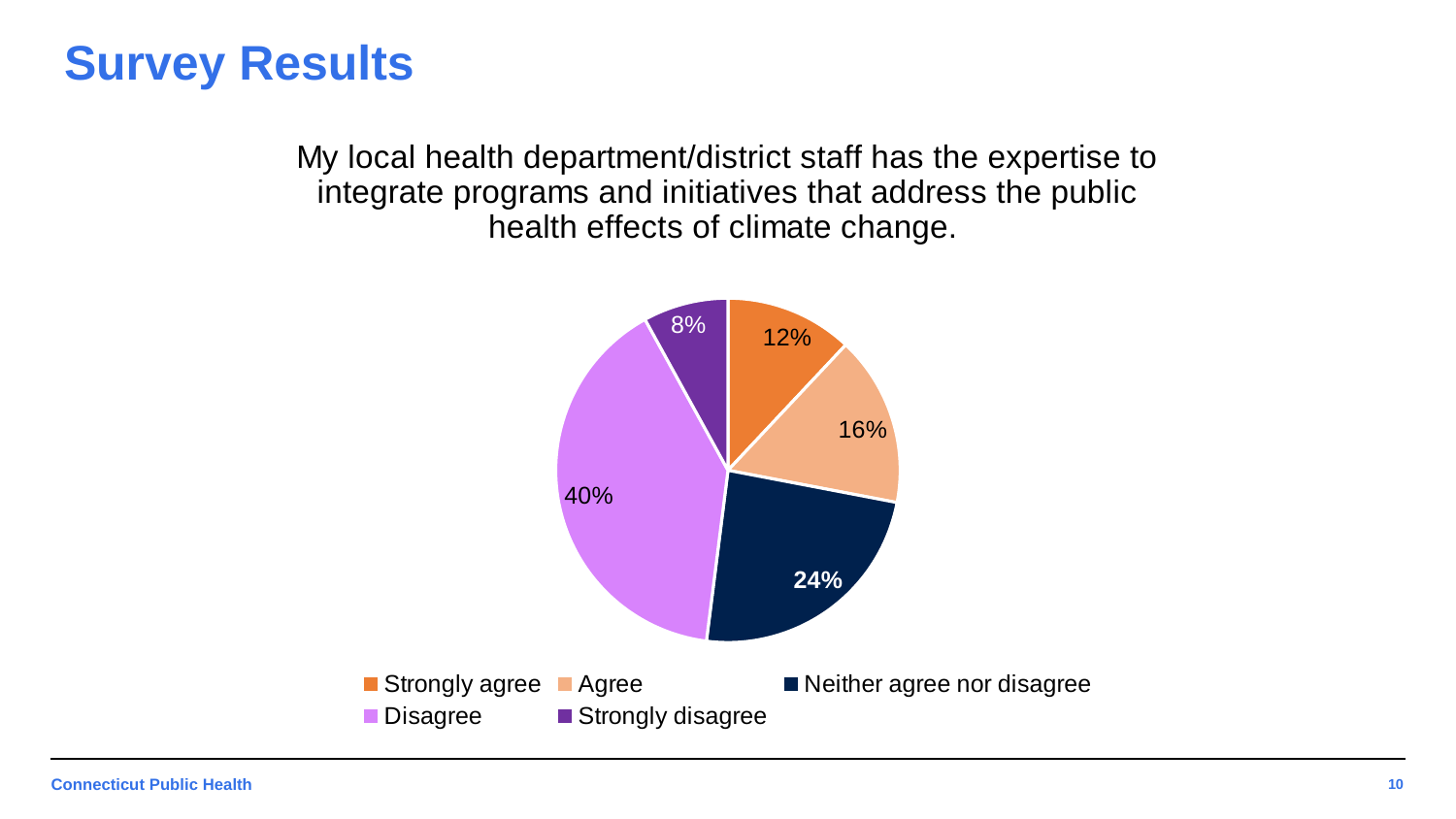
How many response categories does the pie chart show? 5 What colour is the "Neither agree nor disagree" slice? Dark navy blue What percentage of respondents chose "Strongly disagree"? 8% Which is larger, the share for "Agree" or the share for "Strongly agree"? Agree What percentage of respondents chose "Disagree"? 40% What is the combined share of "Strongly agree" and "Agree"? 28% Which response category has the smallest share of the pie? Strongly disagree What is the difference in percentage points between "Disagree" and "Neither agree nor disagree"? 16 What percentage of respondents chose "Neither agree nor disagree"? 24% What kind of chart is shown on the slide? Pie chart What percentage of respondents chose "Strongly agree"? 12% Which response category has the largest share of the pie? Disagree